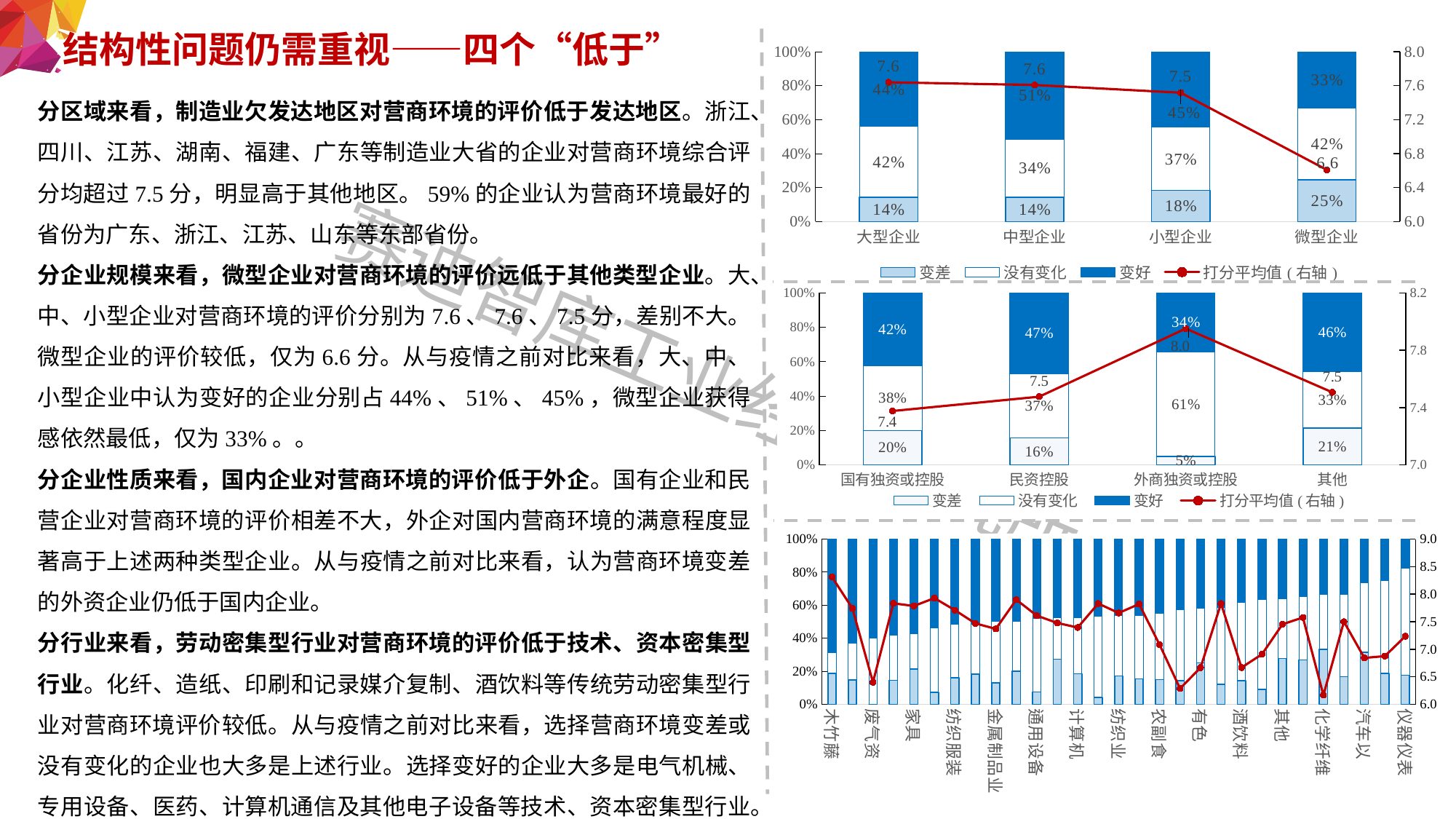
In the middle chart (by enterprise ownership), which category has the highest 没有变化 share? 外商独资或控股 In the top chart (by enterprise size), which enterprise size has the lowest 打分平均值? 微型企业 In the top chart (by enterprise size), which enterprise size has the highest 变差 share? 微型企业 In the top chart (by enterprise size), what percentage of 微型企业 reported 变好? 33% In the top chart (by enterprise size), what is the difference between the 变好 share of 中型企业 and that of 微型企业? 18% In the middle chart (by enterprise ownership), what percentage of 外商独资或控股 enterprises reported 变差? 5% In the middle chart (by enterprise ownership), how many categories are shown on the x axis? 4 In the middle chart (by enterprise ownership), is the 变好 share larger for 民资控股 or for 国有独资或控股? 民资控股 In the top chart (by enterprise size), what is the 打分平均值 for 小型企业? 7.5 In the top chart (by enterprise size), how many series does the legend list? 4 In the middle chart (by enterprise ownership), what is the 打分平均值 for 外商独资或控股? 8.0